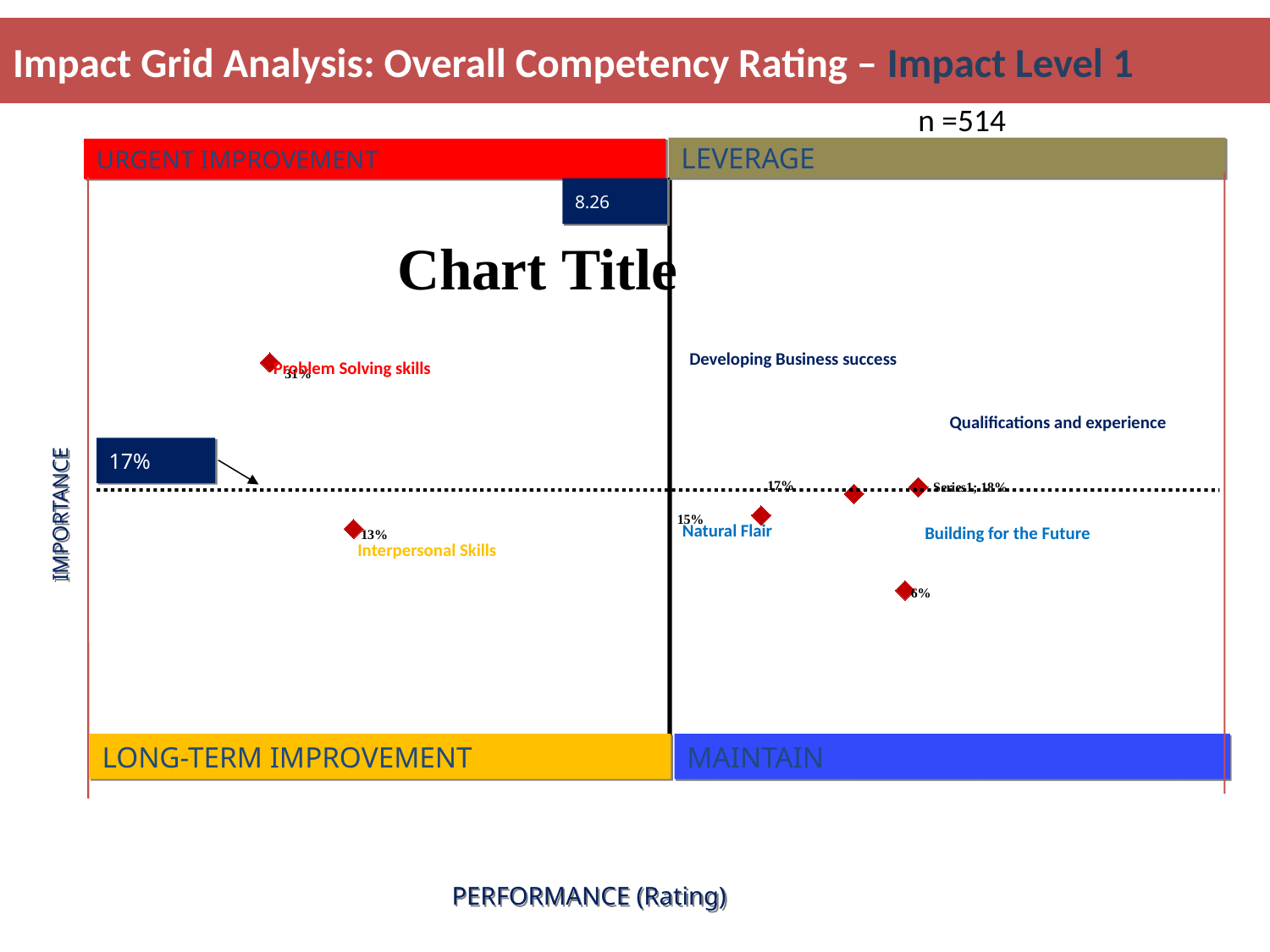
What is the label of the horizontal axis? PERFORMANCE (Rating) What is the difference between the Problem Solving skills value and the Interpersonal Skills value? 18 percentage points What is the name of the bottom-right quadrant of the grid? MAINTAIN What is the data label value for the Natural Flair point? 15% What kind of chart is shown on the slide? scatter chart What is the data label value for the Interpersonal Skills point? 13% Which labelled point has the highest percentage value? Problem Solving skills What is the data label value for the Problem Solving skills point? 31% How many data points are plotted on the chart? 6 What value is shown for the horizontal dotted reference line on the importance axis? 17% What is the lowest percentage data label shown on the chart? 6% Which is larger, the value for Problem Solving skills or the value for Interpersonal Skills? Problem Solving skills